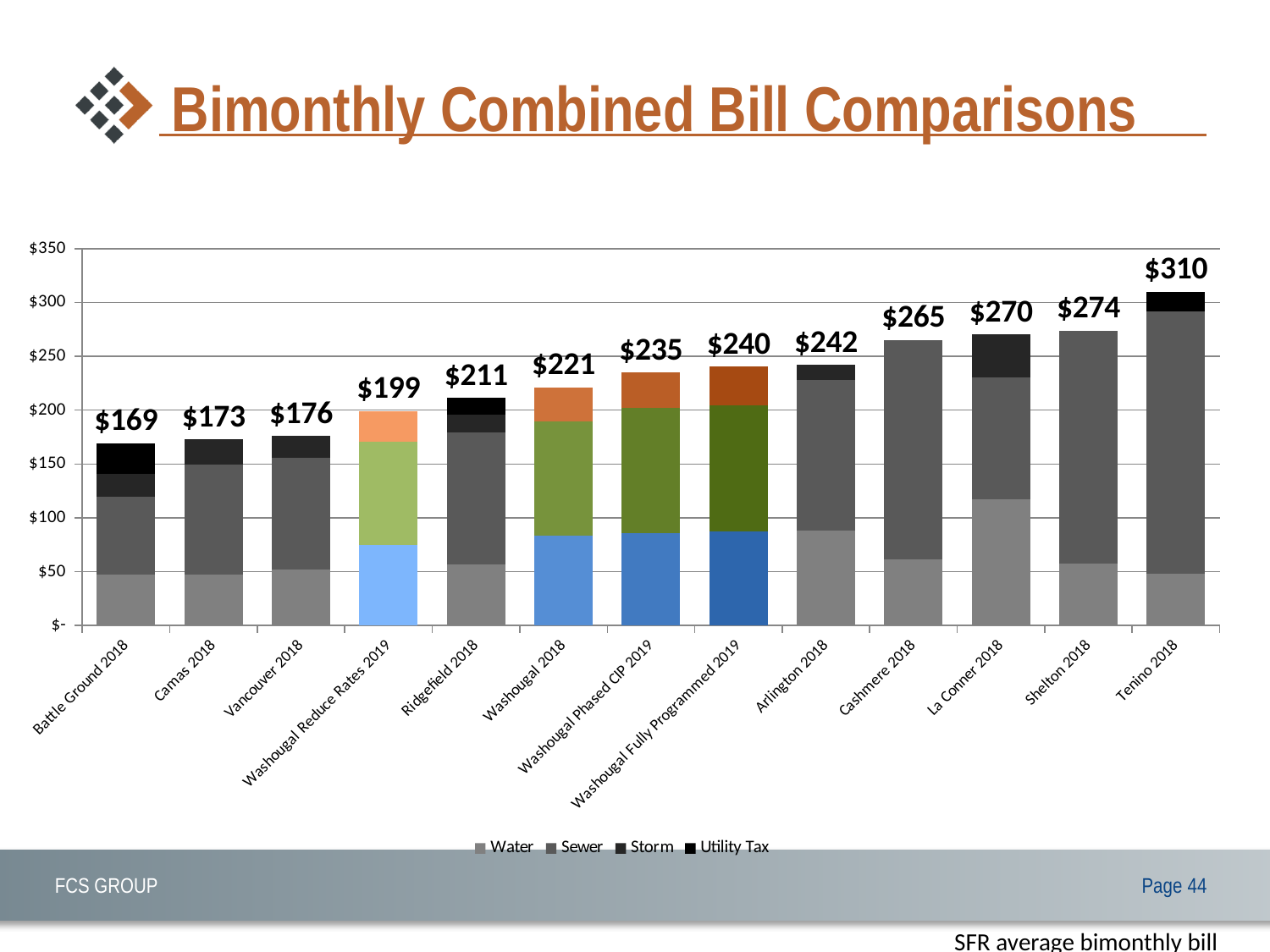
How many categories are shown on the x axis? 13 Which category has the lowest total bill? Battle Ground 2018 What is the difference between the total bills for Tenino 2018 and Battle Ground 2018? $141 Which has a larger total bill, Cashmere 2018 or Arlington 2018? Cashmere 2018 What is the total bill shown for Ridgefield 2018? $211 What is the total bill shown for Washougal Phased CIP 2019? $235 Do the total bills rise or fall moving from left to right along the x axis? rise How many series does the legend list? 4 What is the difference between the total bills for Washougal Fully Programmed 2019 and Washougal Reduce Rates 2019? $41 What is the total bimonthly combined bill shown for Tenino 2018? $310 Which category has the highest total bill? Tenino 2018 Is the Water value for La Conner 2018 greater or less than $100? greater